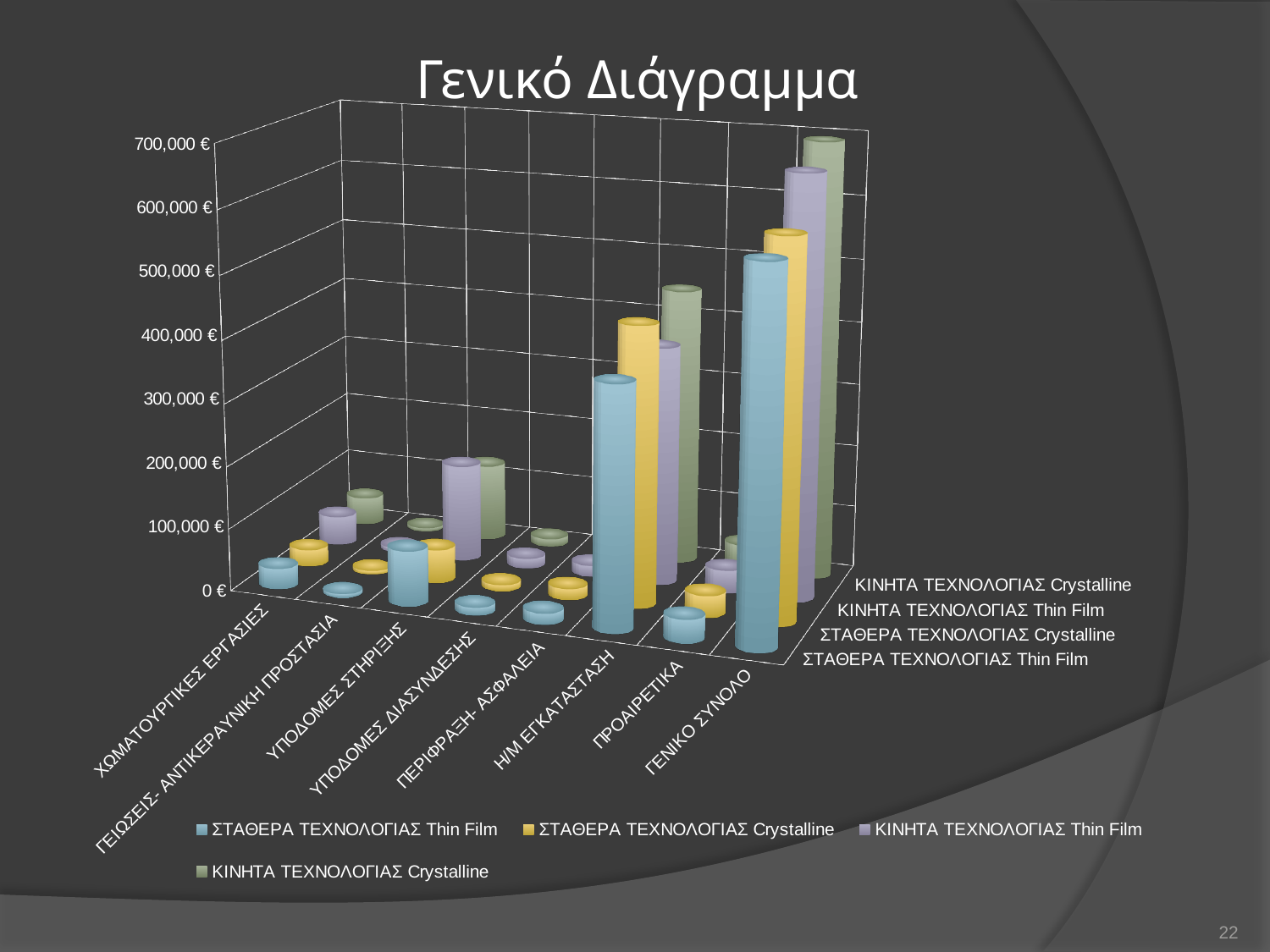
Is the value for ΓΕΝΙΚΟ ΣΥΝΟΛΟ in the ΚΙΝΗΤΑ ΤΕΧΝΟΛΟΓΙΑΣ Crystalline series greater or less than 500,000 €? greater How many categories are shown on the x axis? 8 What is the title of the chart? Γενικό Διάγραμμα Is the value for ΠΡΟΑΙΡΕΤΙΚΑ in the ΚΙΝΗΤΑ ΤΕΧΝΟΛΟΓΙΑΣ Crystalline series greater or less than 200,000 €? less Which colour represents the ΣΤΑΘΕΡΑ ΤΕΧΝΟΛΟΓΙΑΣ Thin Film series in the legend? blue Is the value for ΧΩΜΑΤΟΥΡΓΙΚΕΣ ΕΡΓΑΣΙΕΣ in the ΣΤΑΘΕΡΑ ΤΕΧΝΟΛΟΓΙΑΣ Thin Film series greater or less than 100,000 €? less What is the highest value shown on the vertical axis? 700,000 € What kind of chart is shown on the slide? bar chart In the ΚΙΝΗΤΑ ΤΕΧΝΟΛΟΓΙΑΣ Crystalline series, which is larger: ΓΕΝΙΚΟ ΣΥΝΟΛΟ or ΥΠΟΔΟΜΕΣ ΣΤΗΡΙΞΗΣ? ΓΕΝΙΚΟ ΣΥΝΟΛΟ How many series does the legend list? 4 Which category has the highest bars across all series? ΓΕΝΙΚΟ ΣΥΝΟΛΟ In the ΣΤΑΘΕΡΑ ΤΕΧΝΟΛΟΓΙΑΣ Thin Film series, which is larger: Η/Μ ΕΓΚΑΤΑΣΤΑΣΗ or ΠΡΟΑΙΡΕΤΙΚΑ? Η/Μ ΕΓΚΑΤΑΣΤΑΣΗ